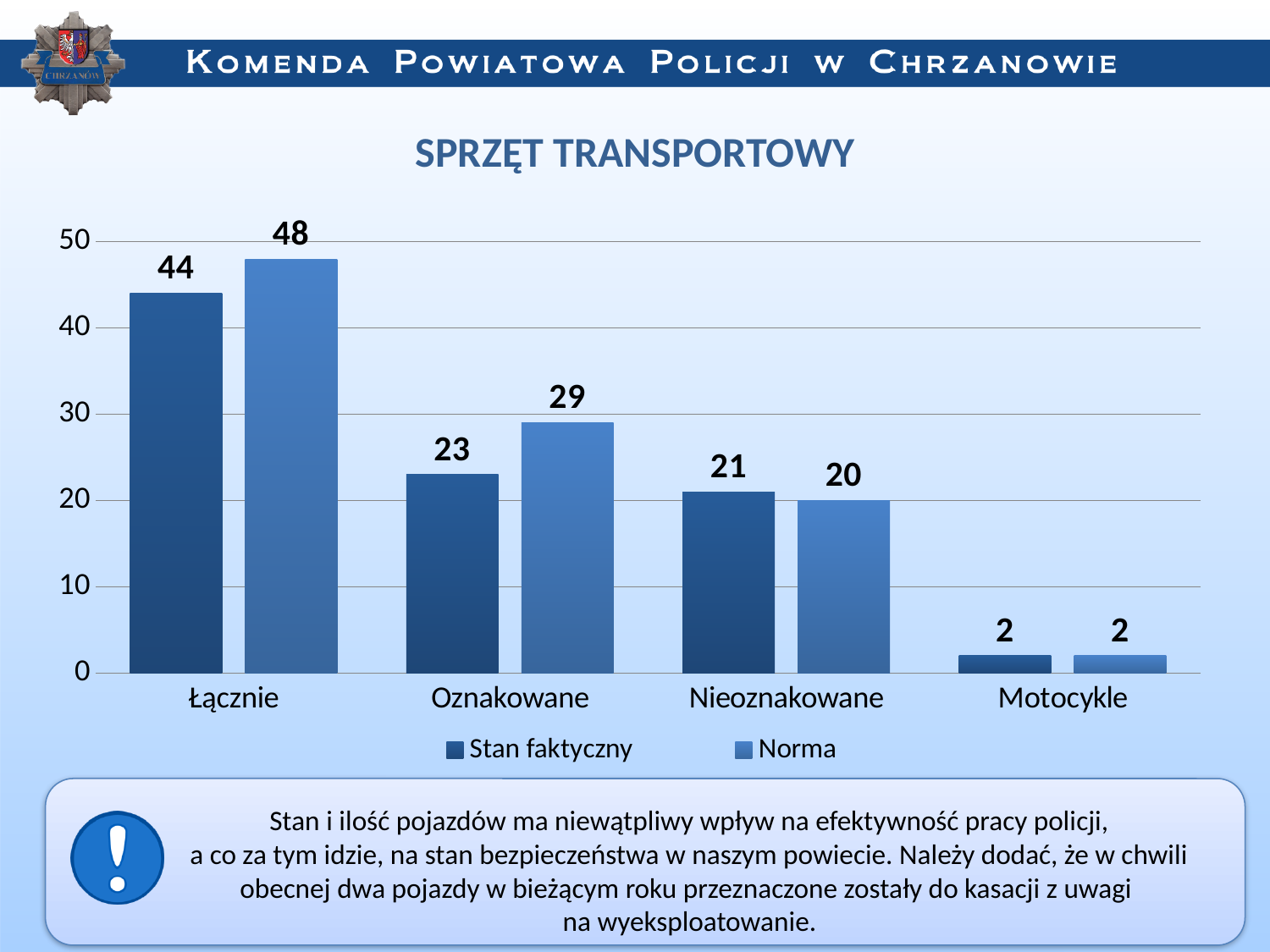
What kind of chart is shown on the slide? Bar chart What is the value of Stan faktyczny for Łącznie? 44 How many categories are shown on the x axis? 4 Which is larger for Nieoznakowane, Stan faktyczny or Norma? Stan faktyczny What is the title of the chart? SPRZĘT TRANSPORTOWY Which category has the highest Norma value? Łącznie What is the value of Norma for Motocykle? 2 How many series does the legend list? 2 What is the value of Norma for Oznakowane? 29 What is the difference between Norma and Stan faktyczny for Oznakowane? 6 What is the value of Stan faktyczny for Nieoznakowane? 21 Which category has the lowest Stan faktyczny value? Motocykle